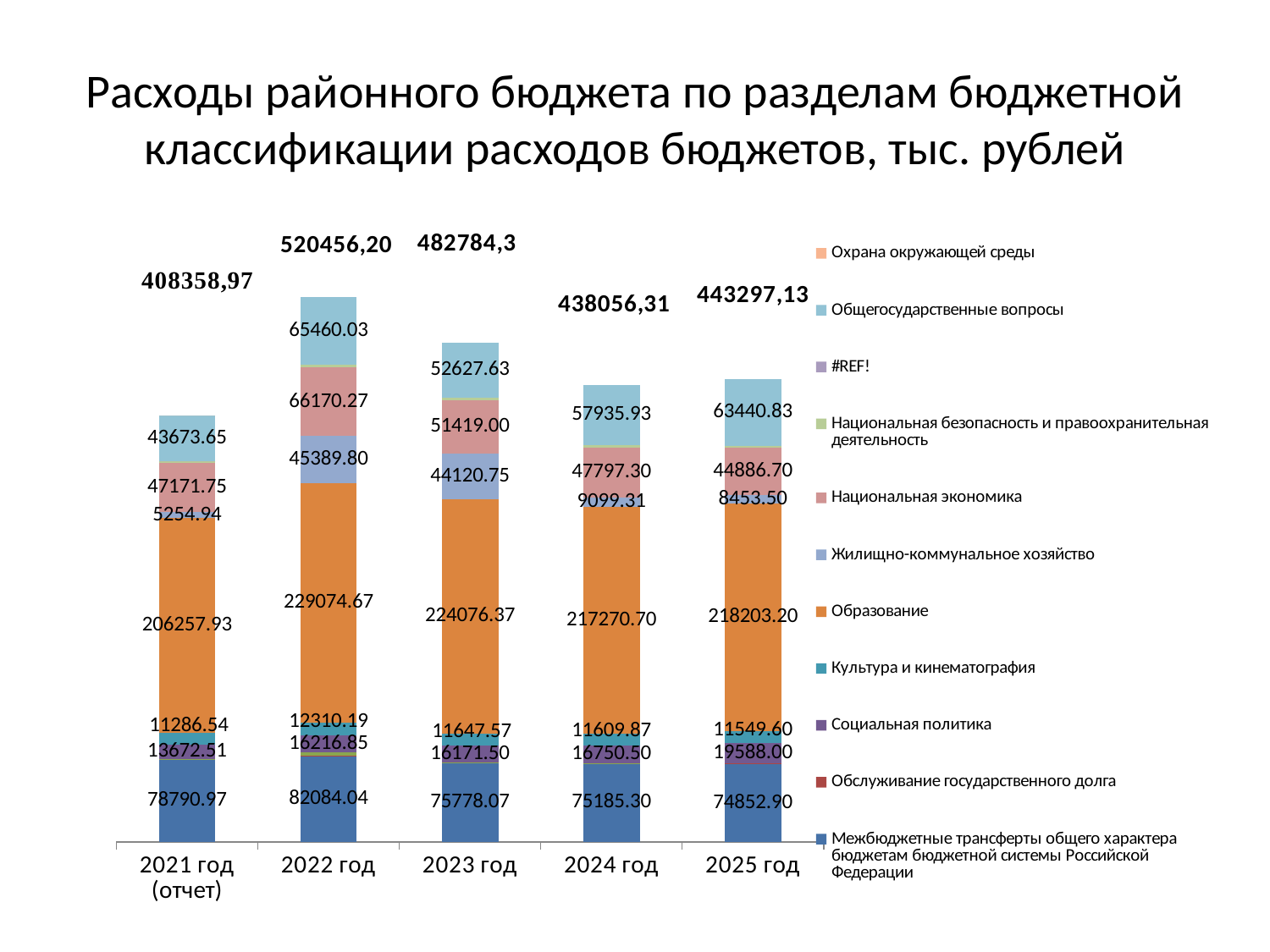
How many series does the legend list? 11 What is the value for Межбюджетные трансферты общего характера бюджетам бюджетной системы Российской Федерации in 2025 год? 74852.90 What is the value for Образование in 2022 год? 229074.67 In which year is the total of the stacked bar the highest? 2022 год What is the total of the stacked bar for 2023 год? 482784,3 What kind of chart is shown on the slide? stacked bar chart Which is larger: the Национальная экономика value in 2022 год or in 2023 год? 2022 год How many years (categories) are shown on the x axis? 5 What is the value for Общегосударственные вопросы in 2021 год (отчет)? 43673.65 In which year is the value for Образование the lowest? 2021 год (отчет) What is the title of the chart? Расходы районного бюджета по разделам бюджетной классификации расходов бюджетов, тыс. рублей What is the difference between the Образование values for 2022 год and 2021 год (отчет)? 22816.74